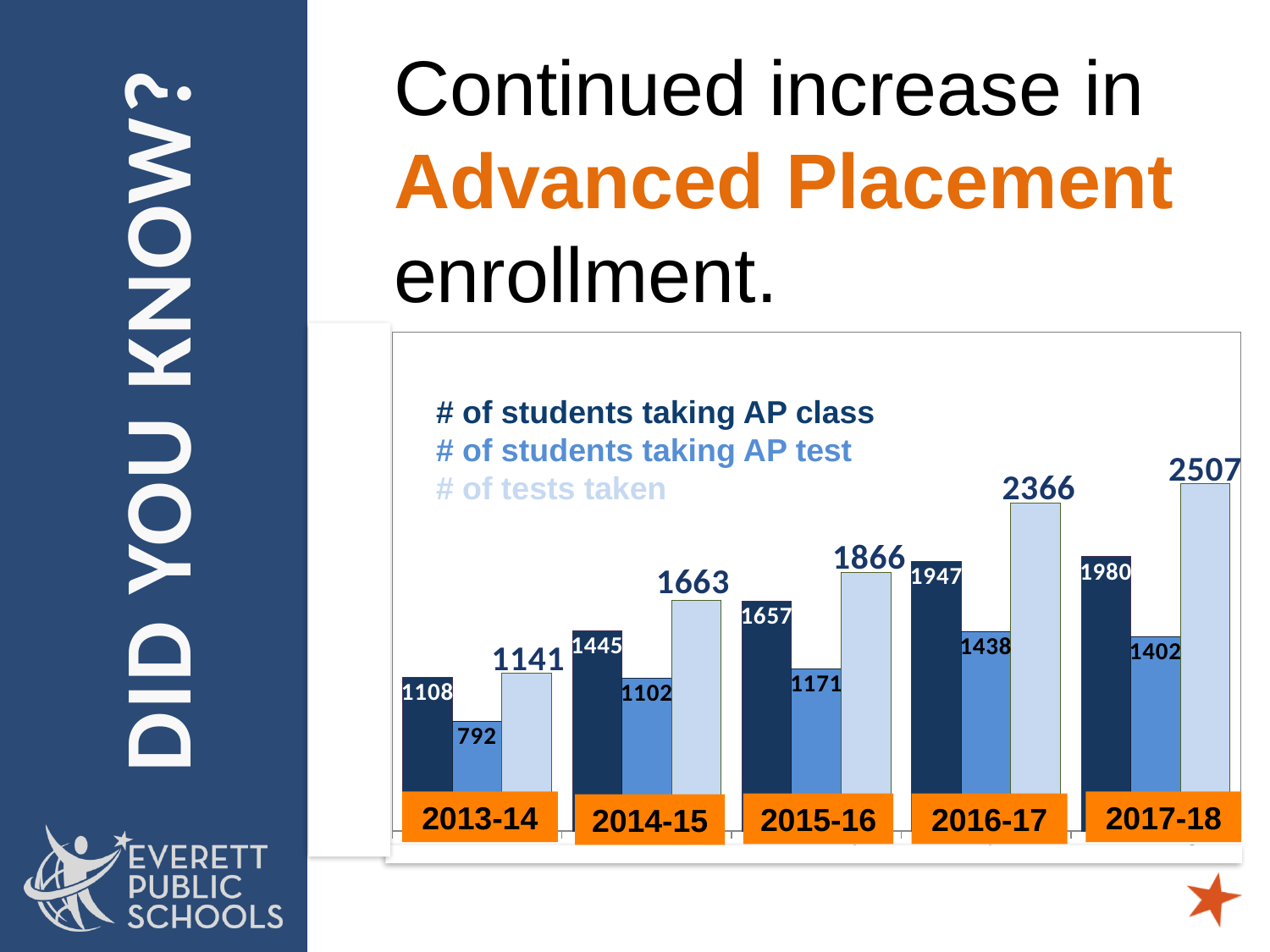
Which is larger: the number of students taking an AP test in 2016-17 or in 2017-18? 2016-17 Does the number of students taking an AP class rise or fall from 2013-14 to 2017-18? rise How many tests were taken in 2017-18? 2507 What kind of chart is shown on the slide? bar chart How many school years are shown on the x axis? 5 Which year has the highest number of tests taken? 2017-18 Which year has the lowest number of students taking an AP class? 2013-14 What is the difference between the number of tests taken in 2017-18 and in 2016-17? 141 Which series is shown in the darkest blue bars? # of students taking AP class How many students took an AP class in 2015-16? 1657 How many series does the legend list? 3 How many students took an AP test in 2013-14? 792